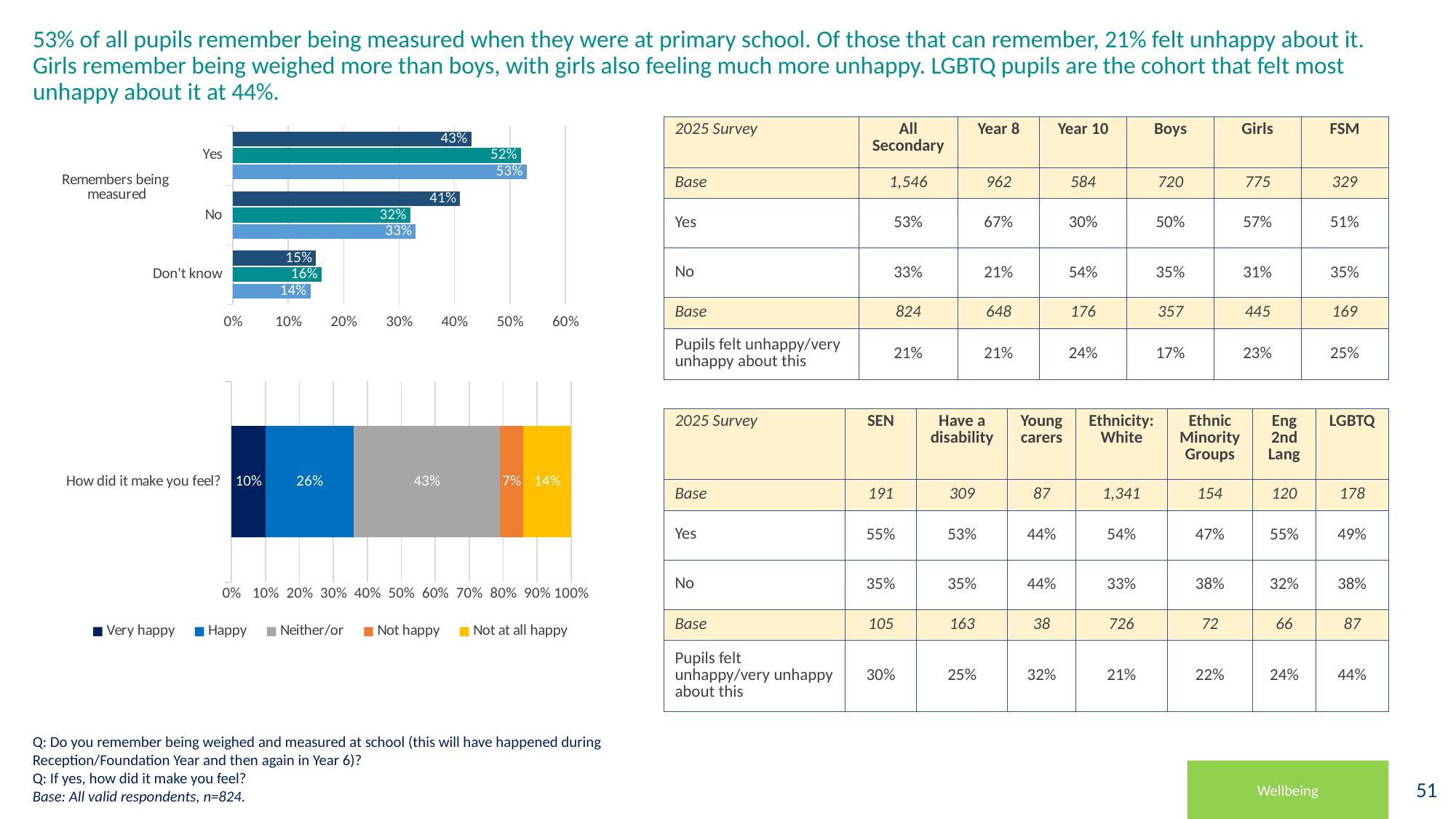
What type of chart is the 'Remembers being measured' chart? Bar chart In the 'How did it make you feel?' chart, which response has the largest share? Neither/or In the 'How did it make you feel?' chart, how many entries does the legend list? 5 In the 'How did it make you feel?' chart, what percentage of pupils said they were 'Neither/or'? 43% In the 'How did it make you feel?' chart, which response has the smallest share? Not happy In the 'How did it make you feel?' chart, what is the total of all segments in the stacked bar? 100% In the 'How did it make you feel?' chart, what percentage of pupils said they were 'Very happy'? 10% In the 'How did it make you feel?' chart, what is the difference between the 'Happy' and 'Very happy' percentages? 16% In the 'Remembers being measured' chart, what value is shown on the teal bar for 'No'? 32% In the 'How did it make you feel?' chart, what percentage of pupils said they were 'Not at all happy'? 14% In the 'Remembers being measured' chart, what value is shown on the light blue bar for 'Yes'? 53% In the 'Remembers being measured' chart, how many response categories are shown? 3